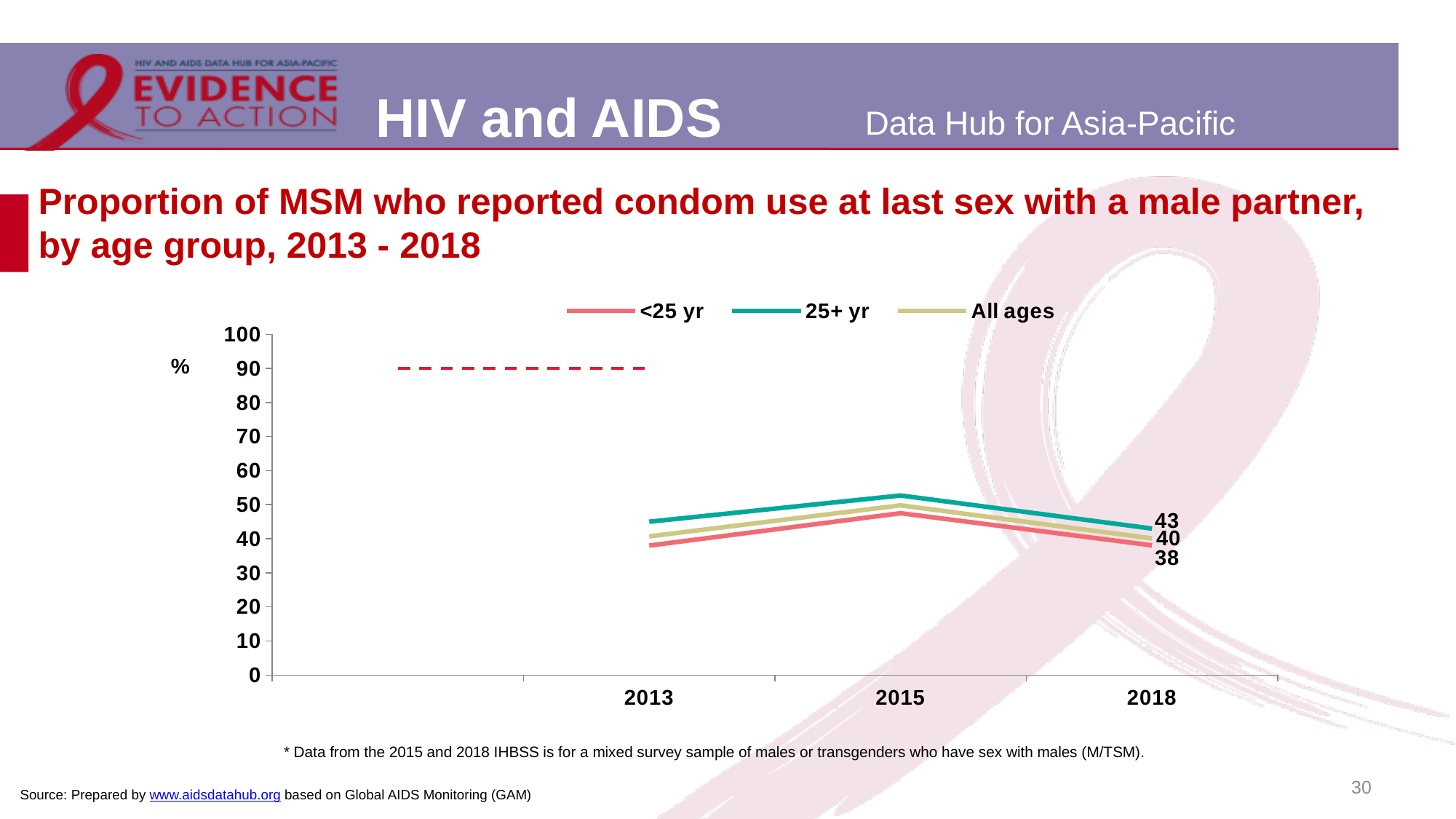
How many series does the legend list? 3 Does the <25 yr series rise or fall from 2015 to 2018? fall Is the value for the <25 yr series in 2015 greater or less than 60? less How many years are shown on the x axis? 3 Which series has the highest value in 2018? 25+ yr What kind of chart is shown on the slide? line chart What is the value for the 25+ yr series in 2018? 43 What is the difference between the 25+ yr and <25 yr values in 2018? 5 In 2018, which series has the larger value: 25+ yr or <25 yr? 25+ yr What is the value for the <25 yr series in 2018? 38 What is the value for the All ages series in 2018? 40 Is the value for the 25+ yr series in 2013 greater or less than 40? greater